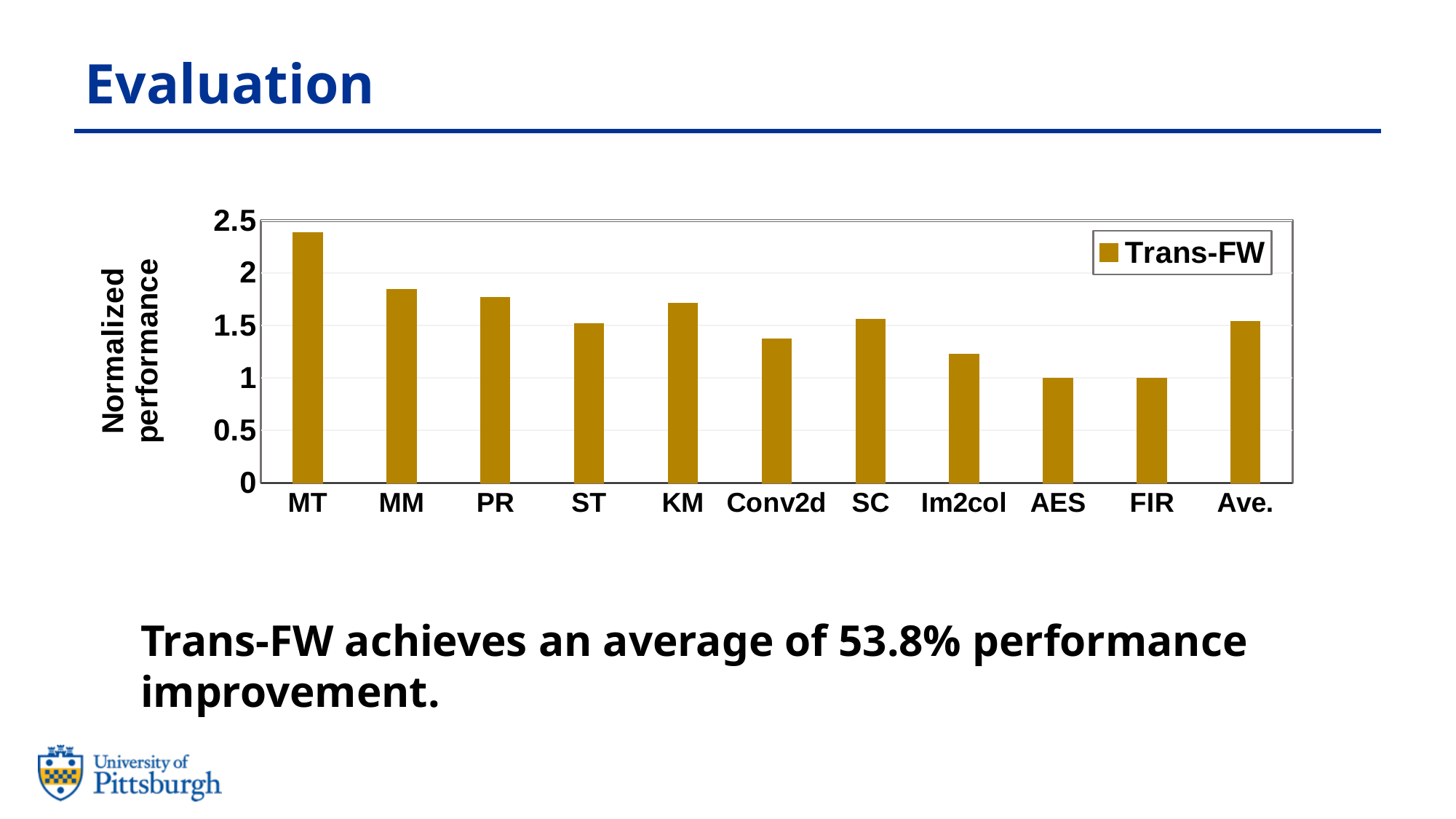
Is the normalized performance for KM greater or less than 1.5? greater Is the normalized performance for MT greater or less than 2? greater Is the normalized performance for MM greater or less than 2? less How many series does the chart's legend list? 1 How many categories are shown on the x axis of the chart? 11 Which has a higher normalized performance, Conv2d or Im2col? Conv2d What is the name of the series shown in the chart's legend? Trans-FW Which has a higher normalized performance, MT or MM? MT Which category has the highest normalized performance? MT What kind of chart is shown on the slide? bar chart